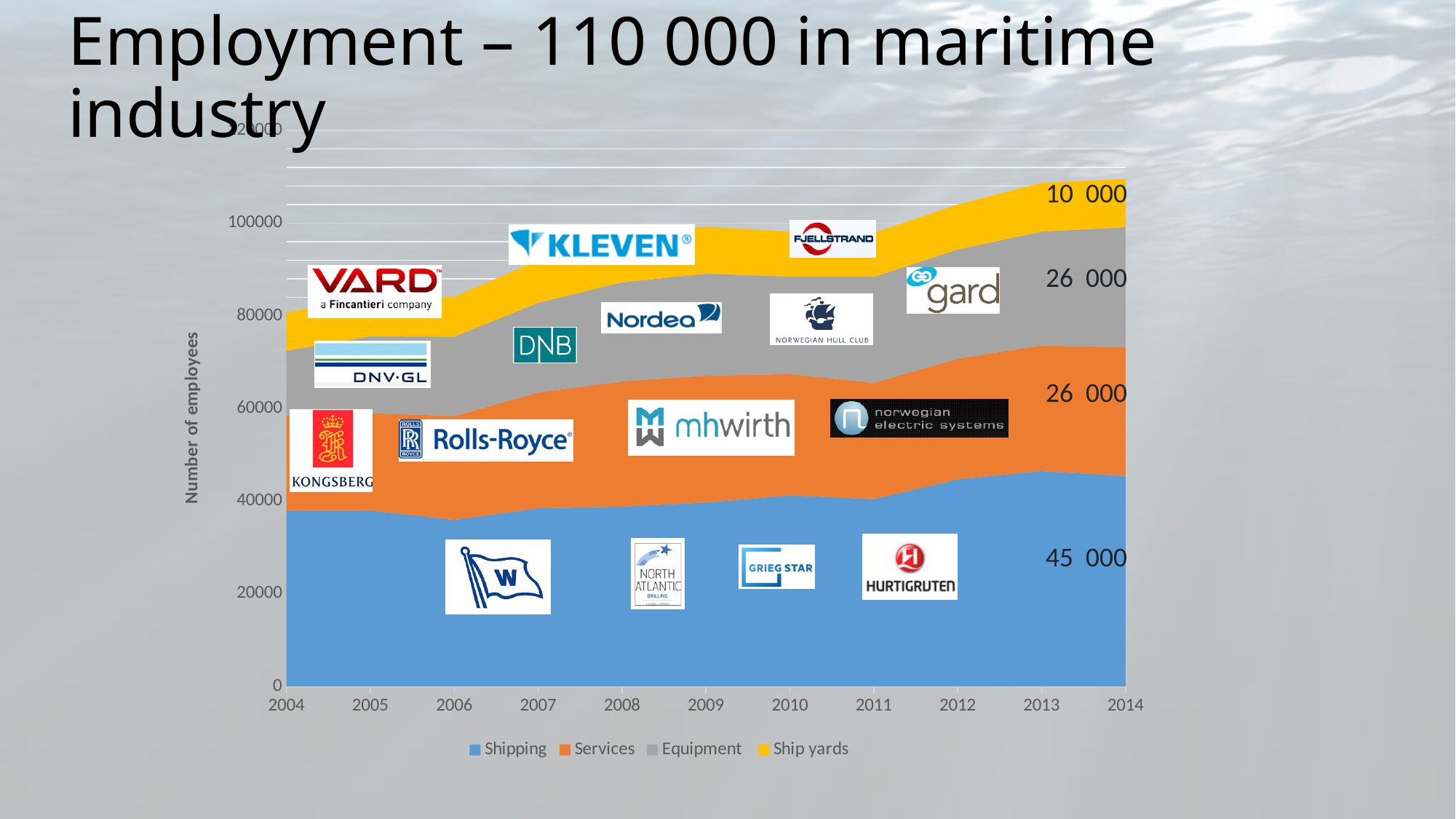
How many series does the legend list? 4 What is the difference between the labelled values for Shipping and Ship yards? 35 000 How many years are shown along the x axis? 11 What is the title of the y axis? Number of employees What is the labelled value for Shipping at the right end of the chart? 45 000 Which series has the smallest labelled value at the right end of the chart? Ship yards Is the total stacked value in 2004 greater or less than 100000? less Does the total number of employees rise or fall from 2004 to 2014? rise What kind of chart is shown on the slide? Stacked area chart What is the labelled value for Equipment at the right end of the chart? 26 000 Which series has the largest labelled value at the right end of the chart? Shipping What is the labelled value for Ship yards at the right end of the chart? 10 000